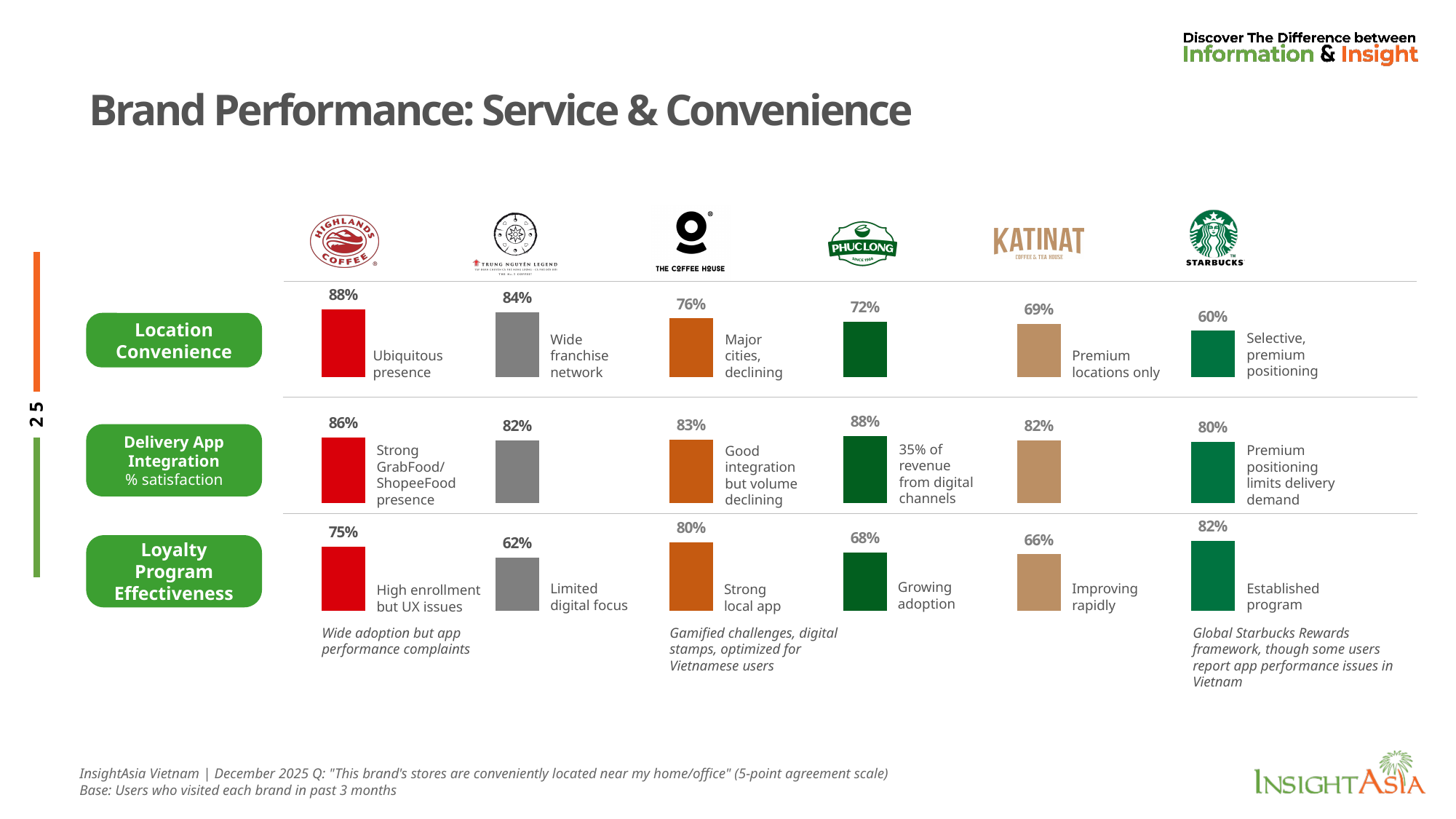
Do the values in the Location Convenience row rise or fall from left to right across the brands? Fall In the Location Convenience row, what is the difference between Highlands Coffee and Starbucks? 28% In the Delivery App Integration row, what is the value for Phuc Long? 88% In the Loyalty Program Effectiveness row, what is the difference between The Coffee House and Katinat? 14% In the Loyalty Program Effectiveness row, which brand has the highest value? Starbucks In the Delivery App Integration row, which is larger: Highlands Coffee or Starbucks? Highlands Coffee In the Loyalty Program Effectiveness row, what is the value for Starbucks? 82% What kind of chart is used to show the brand values on this slide? Bar chart In the Loyalty Program Effectiveness row, which brand has the lowest value? Trung Nguyen Legend How many brands are shown in each row of the chart? 6 In the Location Convenience row, what is the value for Highlands Coffee? 88% In the Location Convenience row, which brand has the lowest value? Starbucks